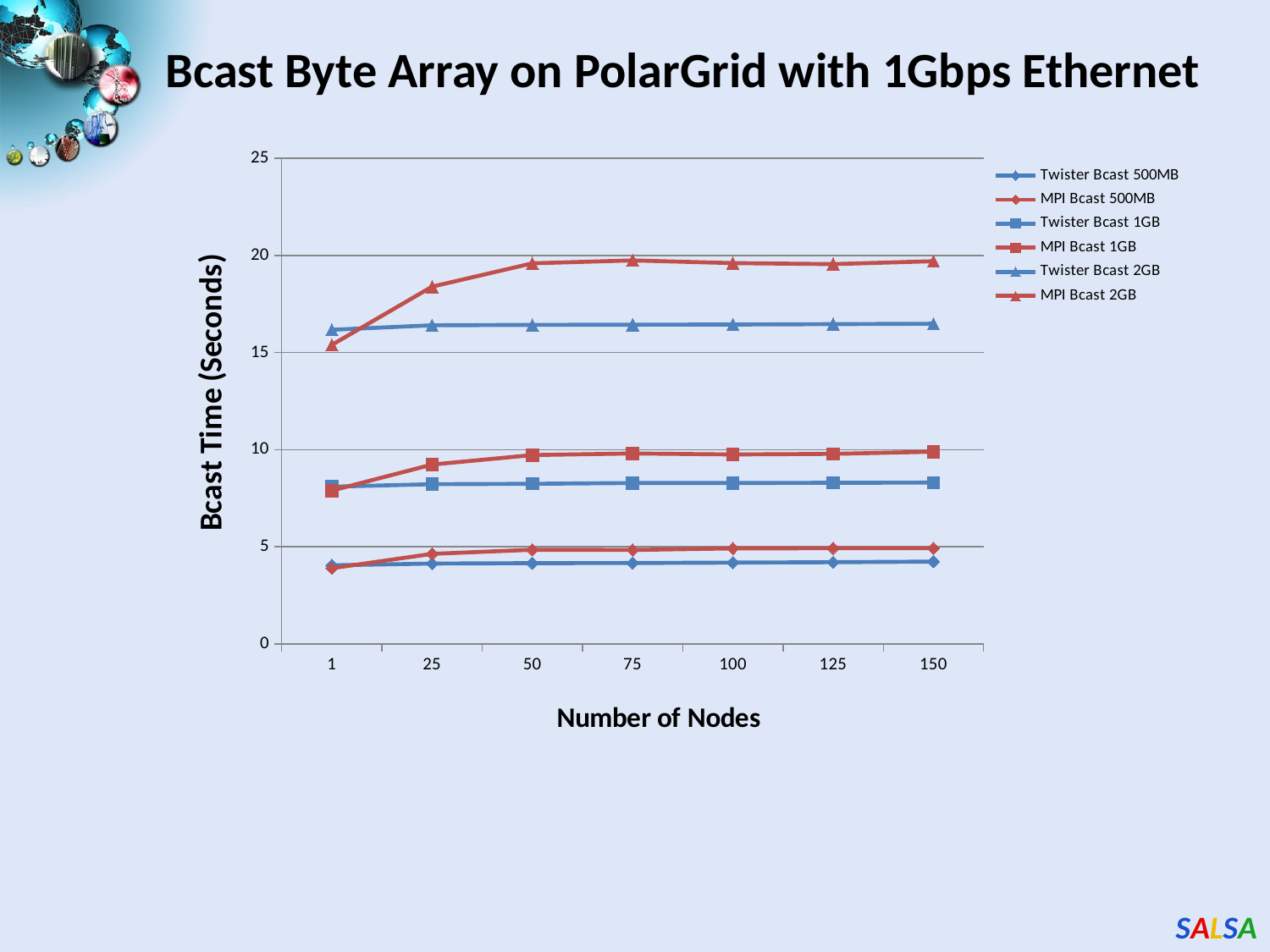
How many node counts are plotted along the x axis? 7 Is the value for Twister Bcast 1GB at 100 nodes greater or less than 10? less Is the value for Twister Bcast 500MB at 150 nodes greater or less than 5? less What kind of chart is shown on the slide? line chart Which series has the highest value at 150 nodes? MPI Bcast 2GB What is the title of the y axis? Bcast Time (Seconds) Is the value for MPI Bcast 2GB at 150 nodes greater or less than 15? greater At 1 node, which is larger: Twister Bcast 2GB or MPI Bcast 2GB? Twister Bcast 2GB Which series has the lowest value at 150 nodes? Twister Bcast 500MB Does the MPI Bcast 2GB series rise or fall from 1 node to 50 nodes? rise At 150 nodes, which is larger: MPI Bcast 2GB or Twister Bcast 2GB? MPI Bcast 2GB How many series does the legend list? 6